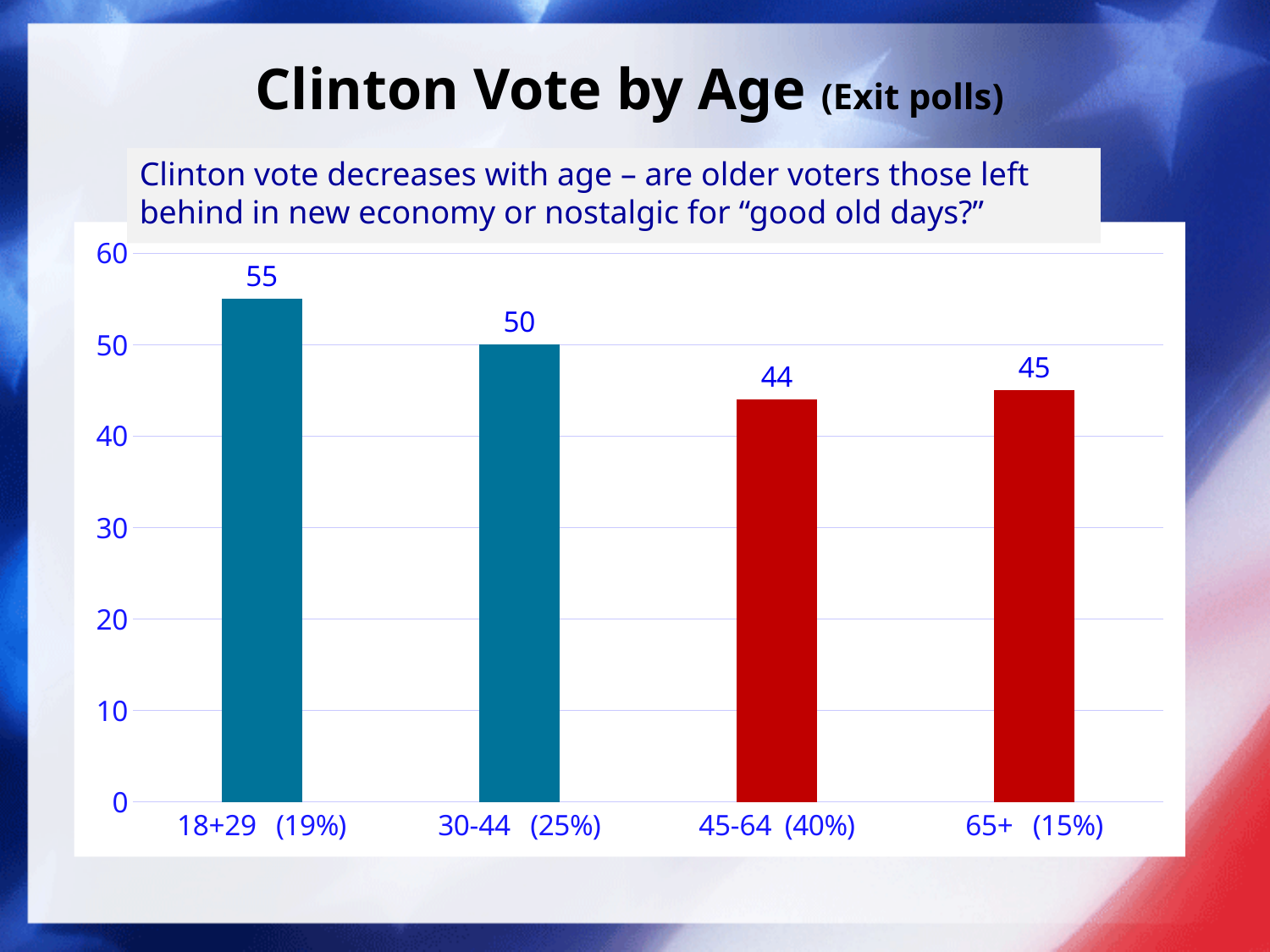
What kind of chart is shown on the slide? Bar chart What is the value for the 45-64 (40%) age group? 44 What is the value for the 30-44 (25%) age group? 50 Which age group has the highest value? 18+29 (19%) What is the title of the slide? Clinton Vote by Age (Exit polls) How many age groups are shown in the chart? 4 Which is larger, the value for 18+29 (19%) or the value for 30-44 (25%)? 18+29 (19%) What is the difference between the values for 18+29 (19%) and 65+ (15%)? 10 What is the value for the 65+ (15%) age group? 45 What is the difference between the values for 30-44 (25%) and 45-64 (40%)? 6 Which age group has the lowest value? 45-64 (40%) What is the value for the 18+29 (19%) age group? 55